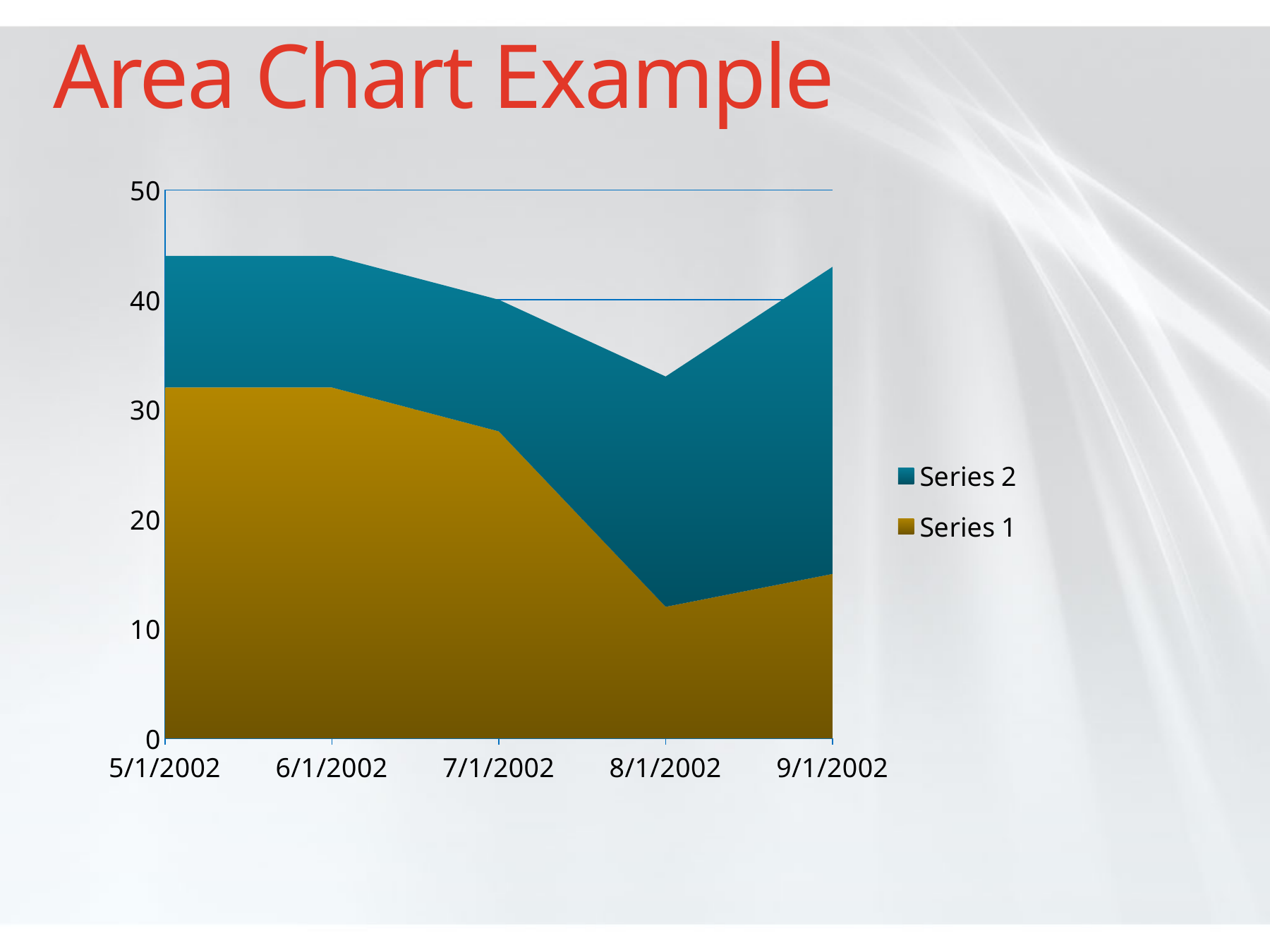
Is the stacked total at 8/1/2002 greater or less than 40? less Is the stacked total at 5/1/2002 greater or less than 40? greater At which date is the stacked total of both series lowest? 8/1/2002 Is the value for Series 1 at 8/1/2002 greater or less than 20? less Which series is shown in the gold/brown colour? Series 1 How many series does the legend list? 2 How many dates are shown on the x axis? 5 What is the title of the slide? Area Chart Example Does the value for Series 1 rise or fall from 5/1/2002 to 8/1/2002? fall What kind of chart is shown on the slide? Area chart At which date is the value for Series 1 lowest? 8/1/2002